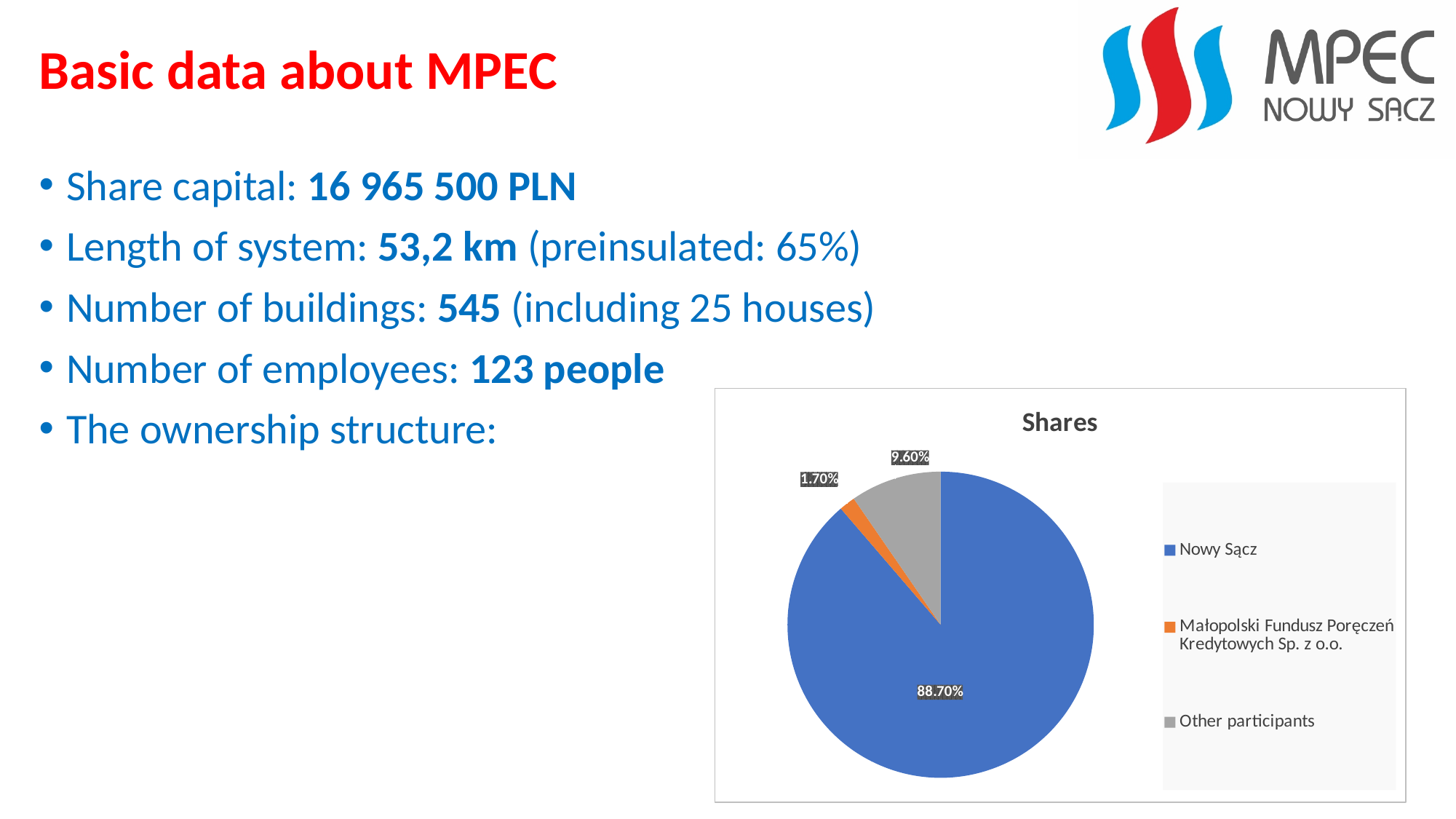
What share of the pie chart does Nowy Sącz hold? 88.70% Which category has the largest slice in the pie chart? Nowy Sącz What kind of chart is shown on the slide? Pie chart Which is larger: the share of Other participants or the share of Małopolski Fundusz Poręczeń Kredytowych Sp. z o.o.? Other participants What share of the pie chart does Other participants hold? 9.60% What colour is the slice for Other participants? Grey Which category has the smallest slice in the pie chart? Małopolski Fundusz Poręczeń Kredytowych Sp. z o.o. What is the difference between the shares of Other participants and Małopolski Fundusz Poręczeń Kredytowych Sp. z o.o.? 7.90% How many categories does the pie chart show? 3 What is the title of the chart? Shares What share of the pie chart does Małopolski Fundusz Poręczeń Kredytowych Sp. z o.o. hold? 1.70% What is the difference between the shares of Nowy Sącz and Other participants? 79.10%